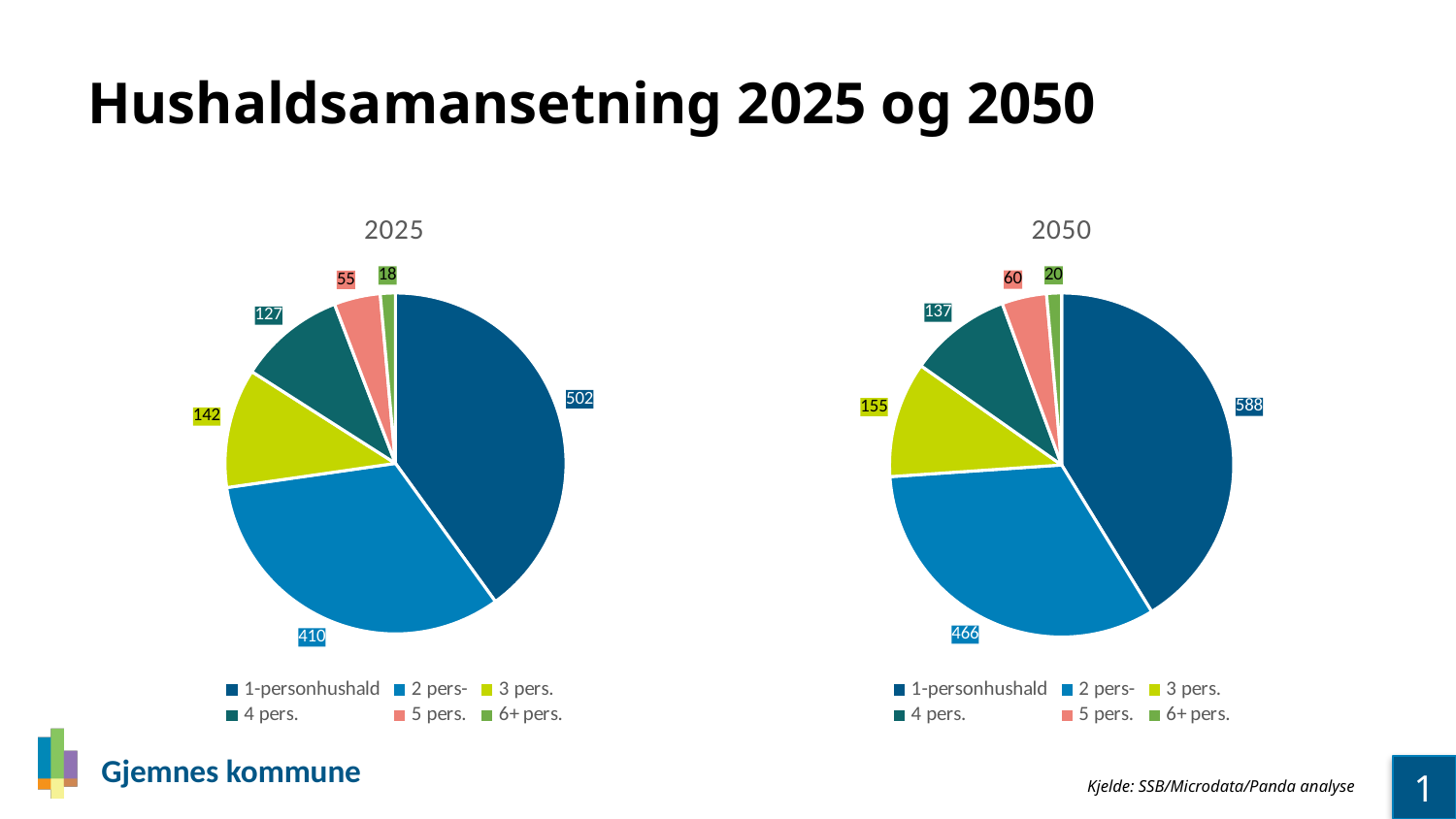
In the 2050 chart, which category has the largest slice? 1-personhushald In the 2050 chart, what is the value for 2 pers-? 466 In the 2025 chart, what is the value for 4 pers.? 127 How many entries does the legend of the 2025 chart list? 6 What is the difference between the 1-personhushald values in the 2050 chart and the 2025 chart? 86 In the 2050 chart, what is the value for 6+ pers.? 20 What type of chart is used for the 2050 data? Pie chart How many slices does the 2025 pie chart have? 6 In the 2025 chart, what is the value for 1-personhushald? 502 In the 2025 chart, which category has the smallest slice? 6+ pers. In the 2050 chart, what is the difference between 3 pers. and 4 pers.? 18 Which is larger: 5 pers. in the 2025 chart or 5 pers. in the 2050 chart? 2050 chart